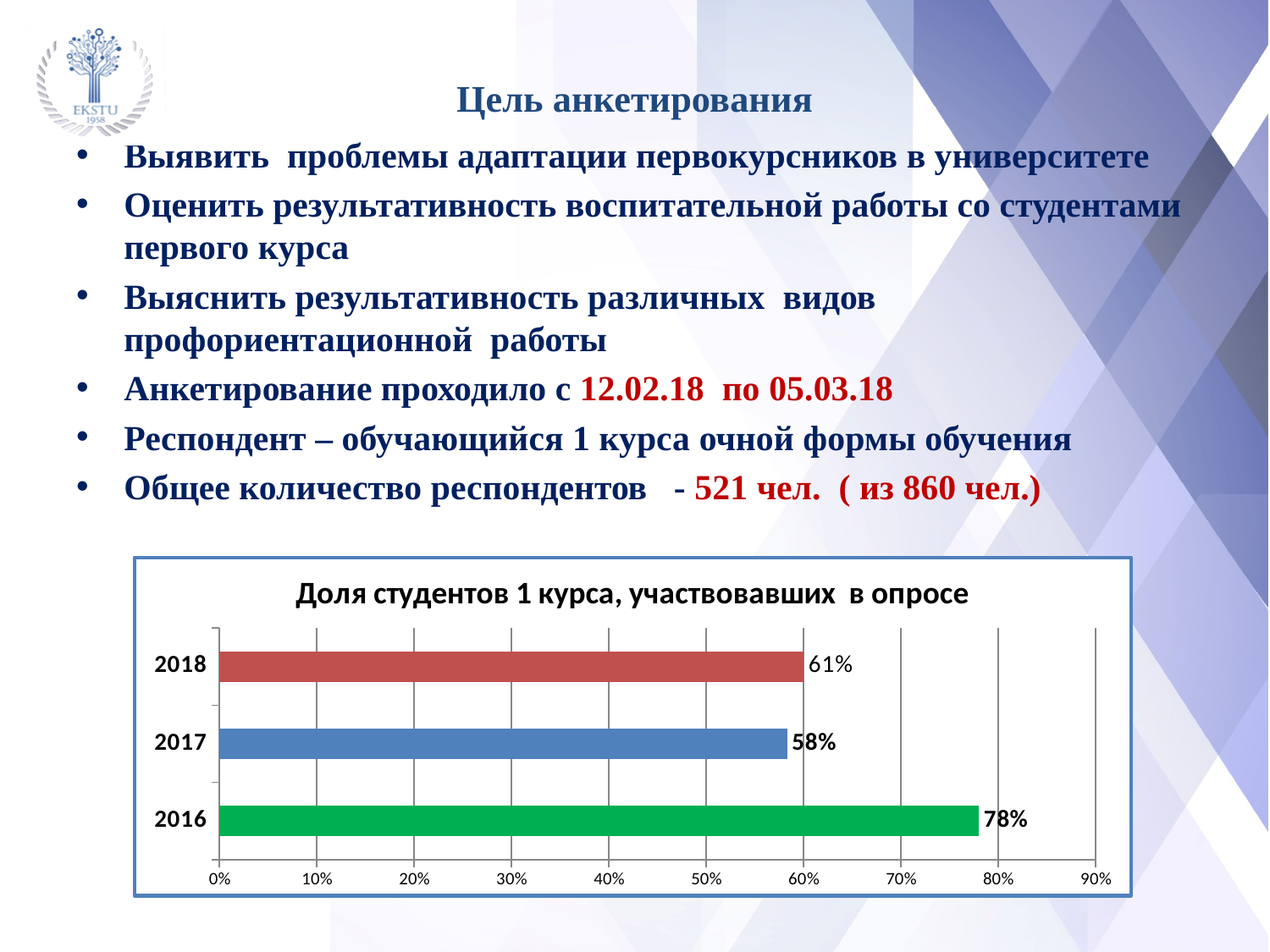
What is the title of the chart? Доля студентов 1 курса, участвовавших в опросе What is the value for 2018? 61% How many years are shown in the chart? 3 What is the value for 2016? 78% What is the difference between the values for 2018 and 2017? 3% Which year has the highest share of first-year students participating in the survey? 2016 What kind of chart is shown on the slide? bar chart What is the value for 2017? 58% Which is larger, the value for 2016 or the value for 2017? 2016 What is the difference between the values for 2016 and 2018? 17% Is the value for 2016 greater or less than 70%? greater Which year has the lowest share of first-year students participating in the survey? 2017